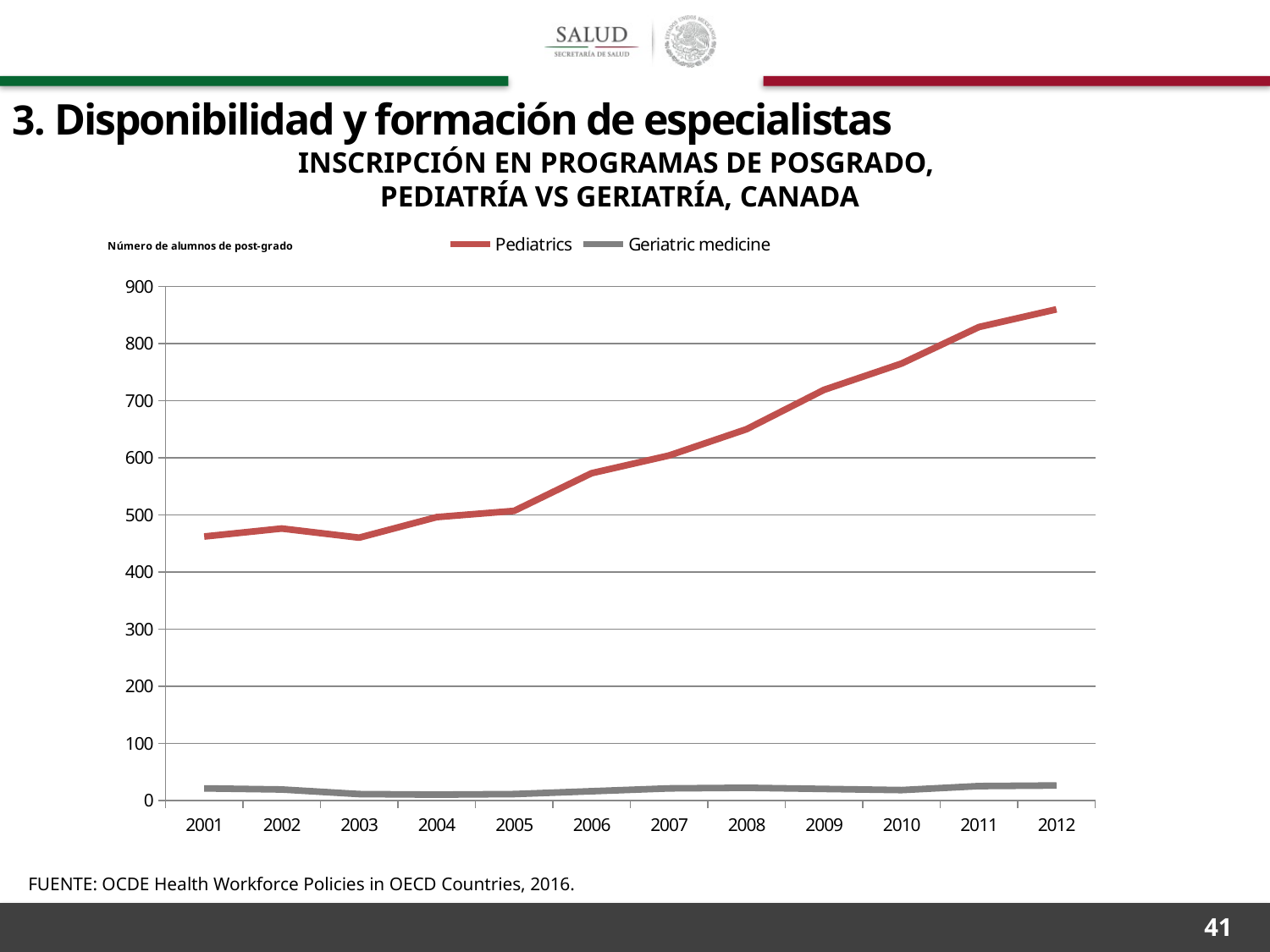
What kind of chart is shown on the slide? Line chart Is the Pediatrics value for 2001 greater or less than 500? less What are the two series named in the legend? Pediatrics and Geriatric medicine Does the Pediatrics series generally rise or fall from 2001 to 2012? Rise Is the Pediatrics value for 2012 greater or less than 800? greater In which year is the Pediatrics series at its highest? 2012 Is the Pediatrics value for 2008 greater or less than 600? greater How many series does the legend list? 2 How many years are plotted along the x axis? 12 Which series has the larger value in 2012, Pediatrics or Geriatric medicine? Pediatrics